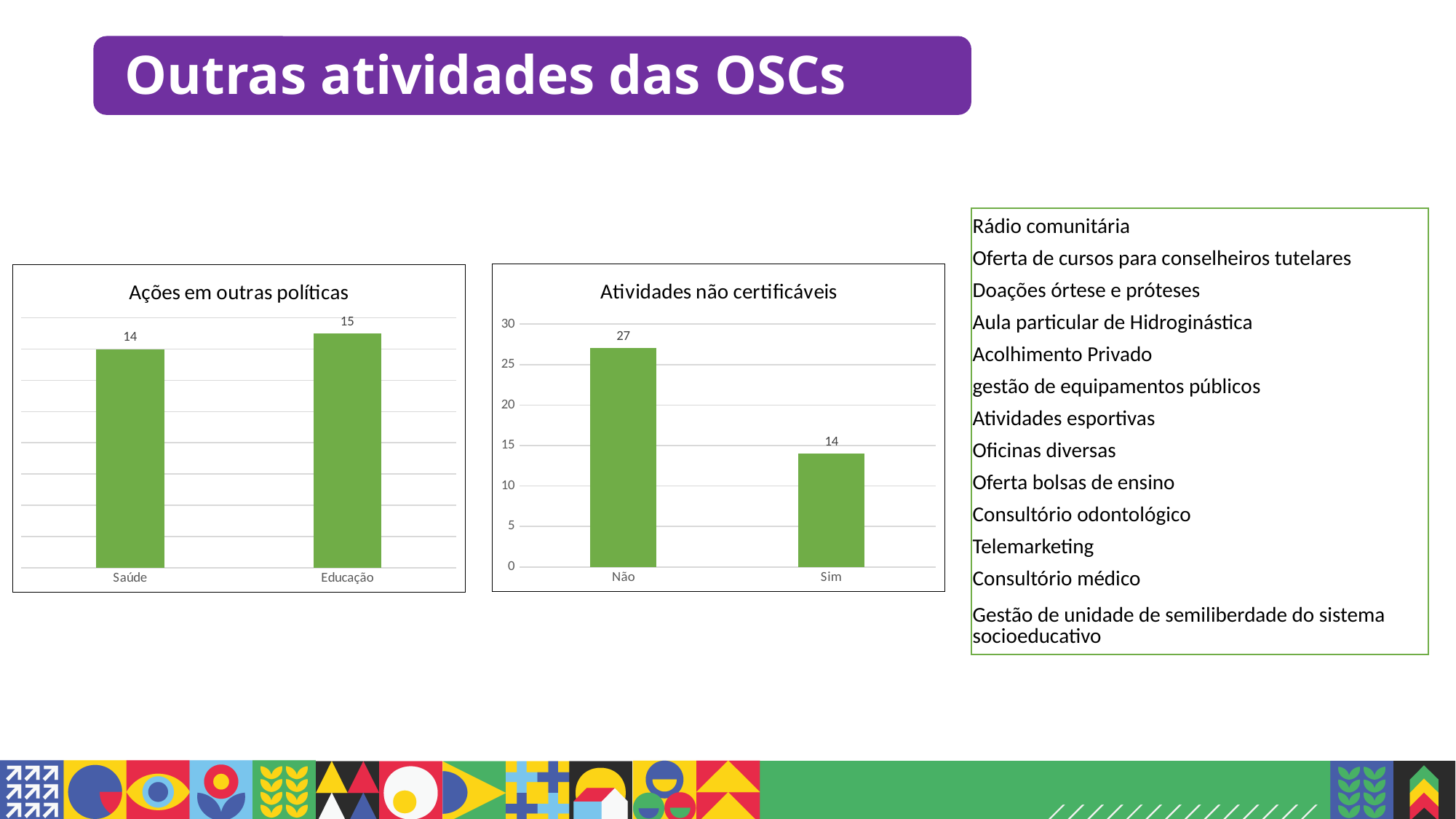
In the 'Ações em outras políticas' chart, how many categories are shown? 2 In the 'Ações em outras políticas' chart, which category has the higher value? Educação What is the title of the chart on the left of the slide? Ações em outras políticas In the 'Ações em outras políticas' chart, what is the difference between Educação and Saúde? 1 What kind of chart is 'Atividades não certificáveis'? Bar chart In the 'Atividades não certificáveis' chart, what is the value for Sim? 14 In the 'Atividades não certificáveis' chart, is the value for Não greater or less than 25? greater In the 'Atividades não certificáveis' chart, what is the difference between Não and Sim? 13 In the 'Atividades não certificáveis' chart, what is the value for Não? 27 In the 'Ações em outras políticas' chart, what is the value for Saúde? 14 In the 'Atividades não certificáveis' chart, which category has the lowest value? Sim In the 'Ações em outras políticas' chart, what is the value for Educação? 15